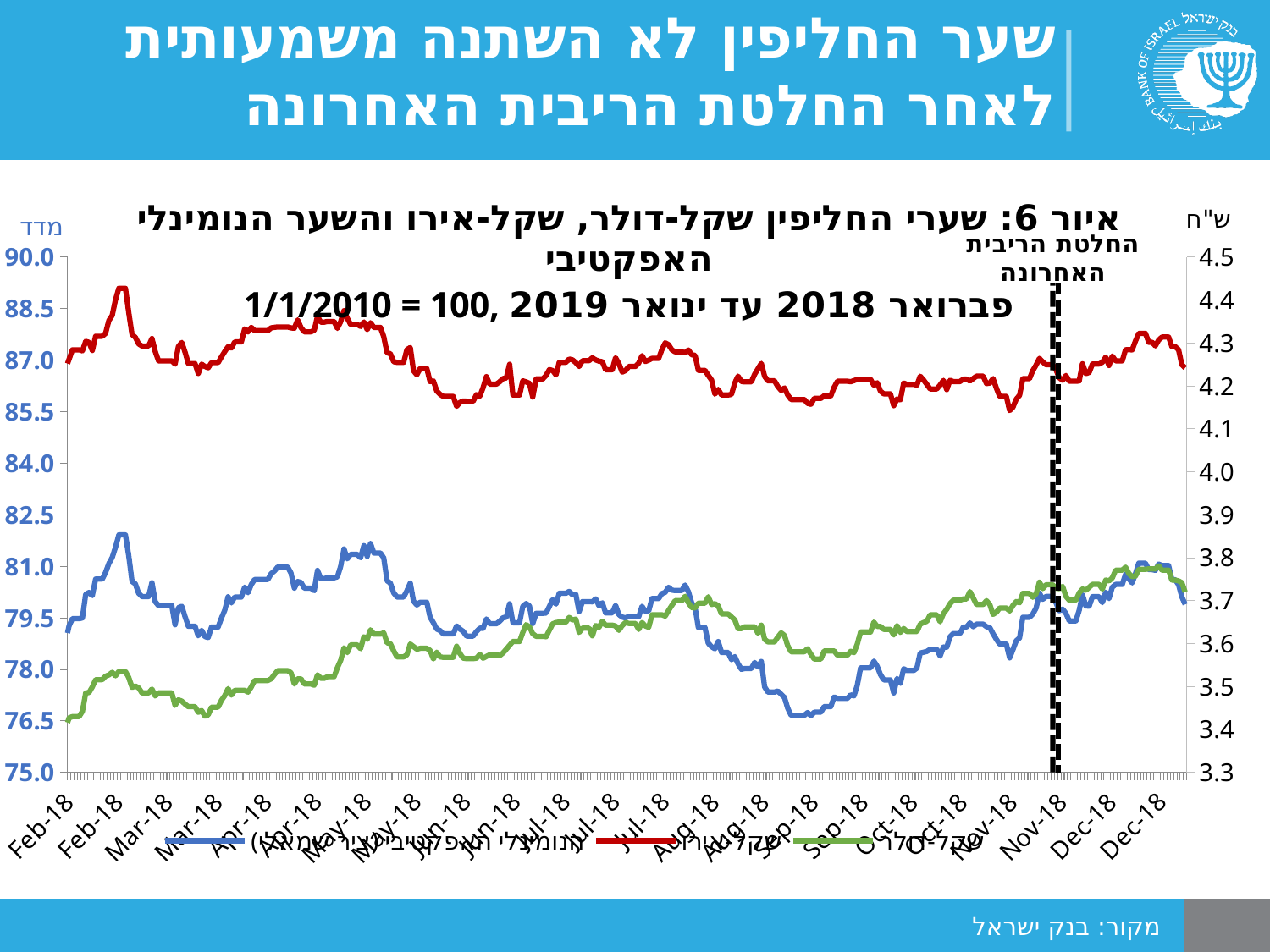
How many series are plotted in the chart? 3 Is the value of the green (שקל-דולר) line in Dec-18 greater or less than 3.7 on the right axis? greater Is the value of the green (שקל-דולר) line at the start of the chart in Feb-18 greater or less than 3.5 on the right axis? less Is the value of the red (שקל-אירו) line at its peak in Feb-18 greater or less than 4.3 on the right axis? greater What does the dashed vertical line near Nov-18 mark, according to the annotation on the chart? החלטת הריבית האחרונה What kind of chart is shown on the slide? line chart Does the green (שקל-דולר) line rise or fall overall from Feb-18 to Dec-18? rise What is the figure number given in the chart title? איור 6 Which line is higher on the right axis throughout the chart, the red (שקל-אירו) line or the green (שקל-דולר) line? red (שקל-אירו)